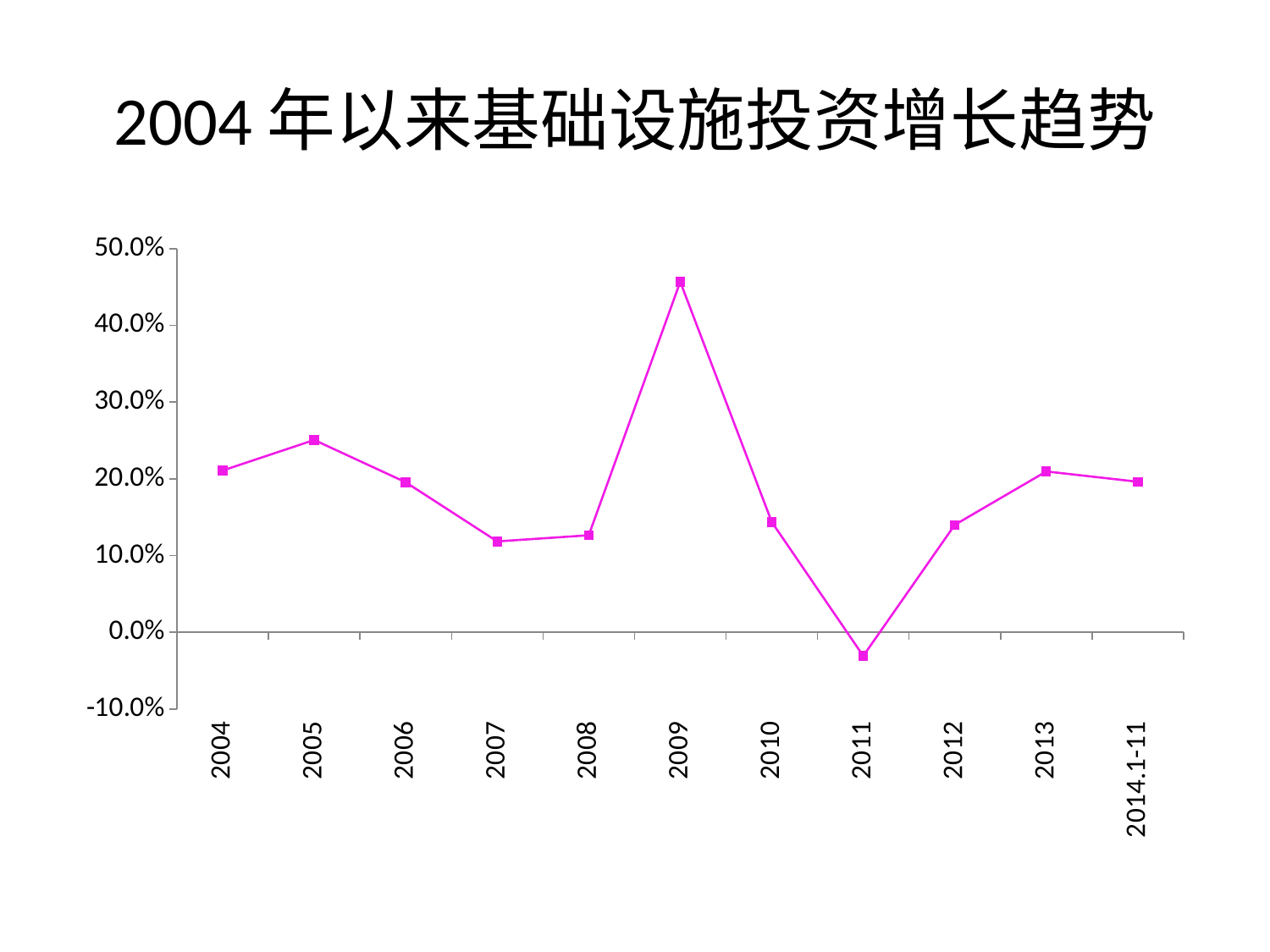
Which year has the highest value? 2009 What is the title of the chart? 2004 年以来基础设施投资增长趋势 Which year has the lowest value? 2011 Is the value for 2005 greater or less than 20.0%? greater Is the value for 2007 greater or less than 20.0%? less Do the values rise or fall from 2009 to 2011? fall Is the value for 2009 greater or less than 40.0%? greater How many data points are plotted along the x axis? 11 Which is larger, the value for 2005 or the value for 2006? 2005 Which is larger, the value for 2012 or the value for 2013? 2013 What kind of chart is shown on the slide? line chart